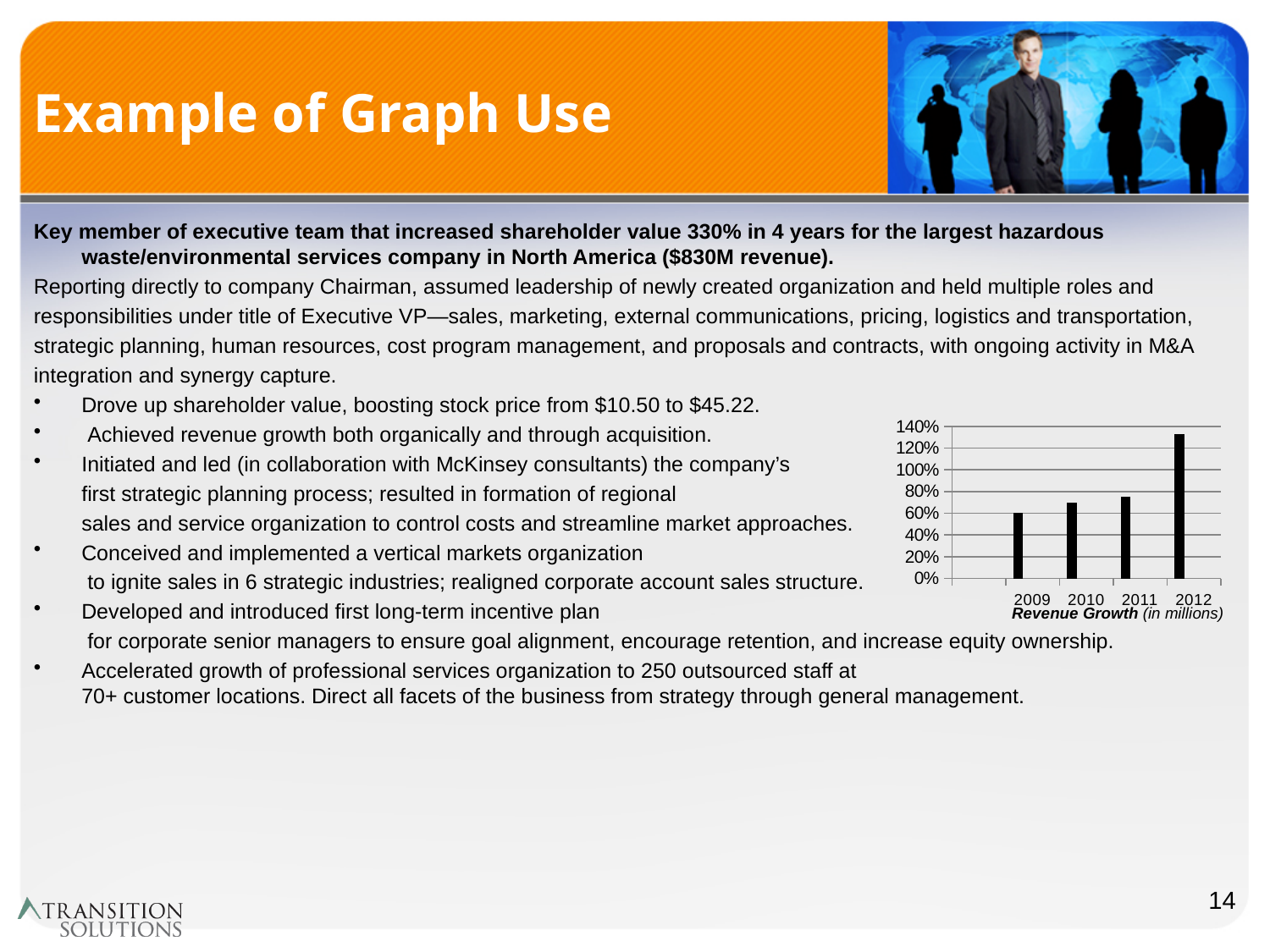
Is the value for 2010 greater or less than 80%? less Do the values in the Revenue Growth chart rise or fall from 2009 to 2012? rise Is the value for 2012 greater or less than 140%? less Which year has the lowest bar in the Revenue Growth chart? 2009 Is the value for 2009 greater or less than 40%? greater How many years are shown on the x axis of the Revenue Growth chart? 4 What is the caption printed below the chart? Revenue Growth (in millions) Which is larger, the value for 2012 or the value for 2011? 2012 Which year has the highest bar in the Revenue Growth chart? 2012 What kind of chart is shown on the slide? bar chart